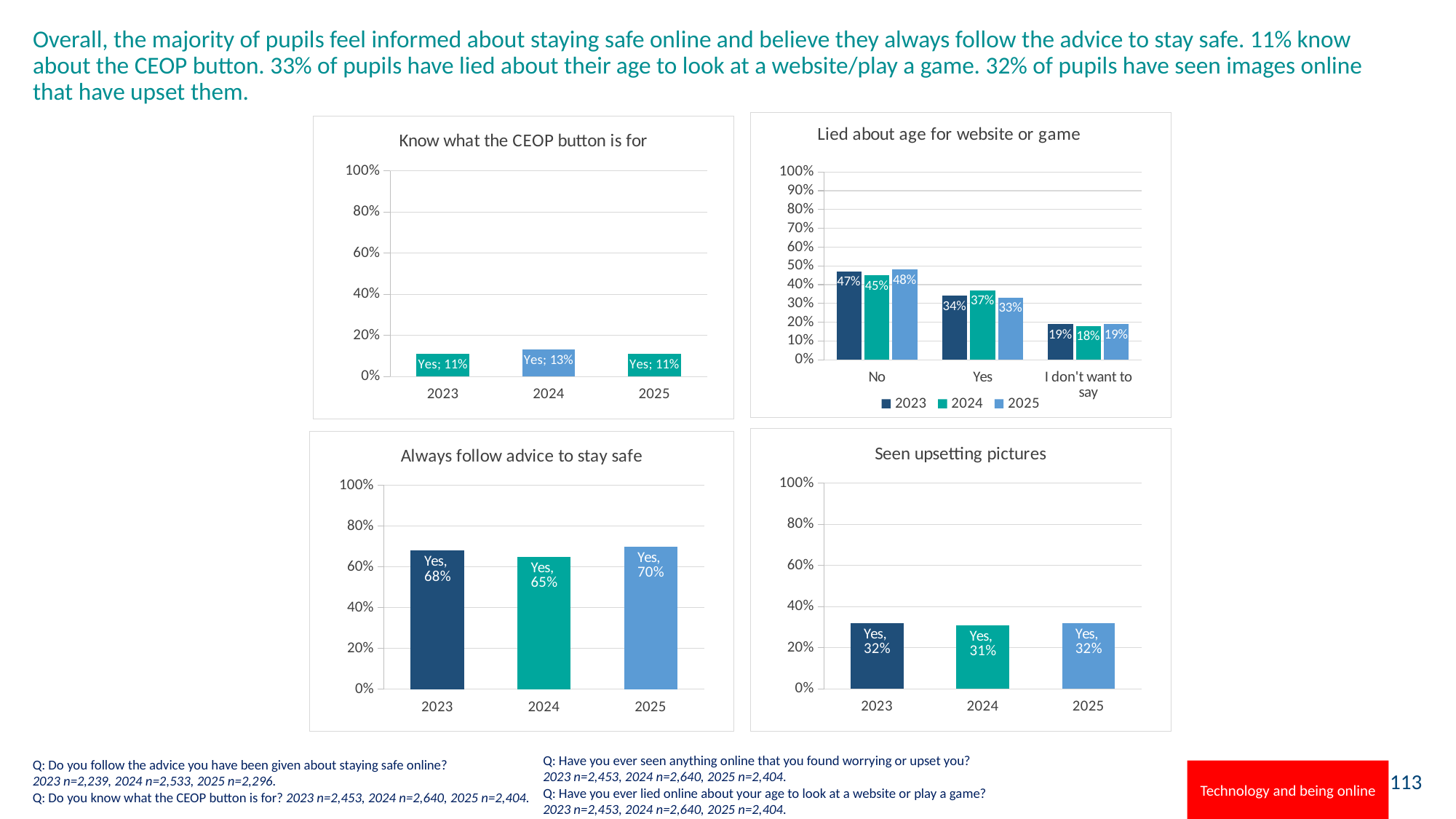
In the 'Lied about age for website or game' chart, what is the difference between the 2023 values for 'No' and 'Yes'? 13% In the 'Always follow advice to stay safe' chart, is the value for 2023 greater or less than 60%? greater In the 'Always follow advice to stay safe' chart, which year has the lowest value? 2024 In the 'Always follow advice to stay safe' chart, what is the value for 2025? 70% What kind of chart is the 'Seen upsetting pictures' chart? Bar chart In the 'Know what the CEOP button is for' chart, what is the value for 2024? 13% In the 'Lied about age for website or game' chart, how many series does the legend list? 3 In the 'Know what the CEOP button is for' chart, which year has the highest value? 2024 In the 'Lied about age for website or game' chart, which category has the lowest values? I don't want to say In the 'Lied about age for website or game' chart, what is the 2024 value for 'Yes'? 37% In the 'Seen upsetting pictures' chart, what is the value for 2024? 31% In the 'Lied about age for website or game' chart, what is the 2025 value for 'No'? 48%